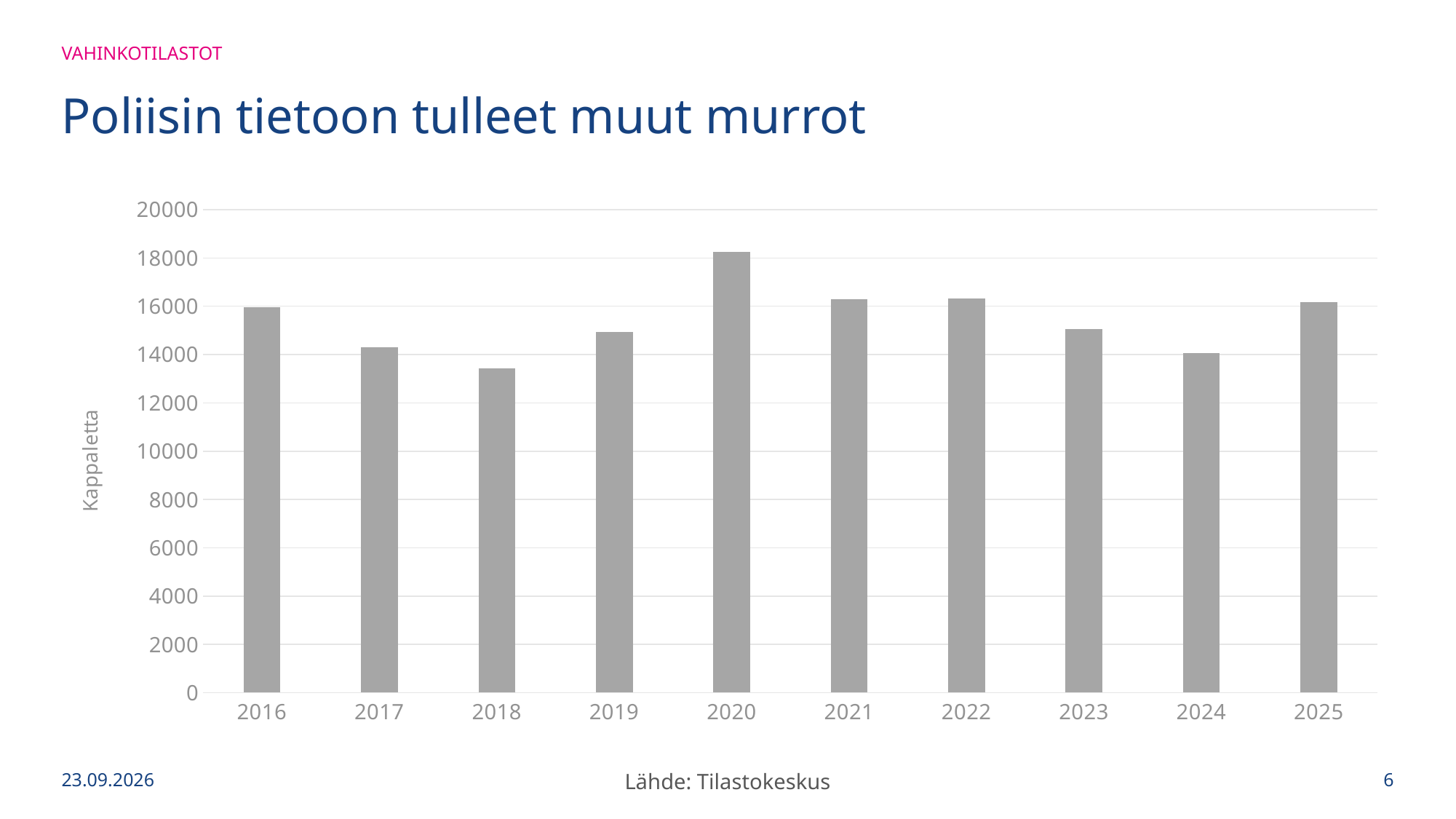
Which year has the larger value, 2020 or 2016? 2020 What kind of chart is shown on the slide? bar chart Do the values rise or fall from 2016 to 2018? fall Which year has the highest bar in the chart? 2020 Is the value for 2023 greater or less than 14000? greater What is the label on the vertical axis of the chart? Kappaletta Is the value for 2018 greater or less than 14000? less Do the values rise or fall from 2018 to 2020? rise How many years are shown on the x axis of the chart? 10 Which year has the lowest bar in the chart? 2018 Which year has the larger value, 2017 or 2019? 2019 Is the value for 2020 greater or less than 16000? greater